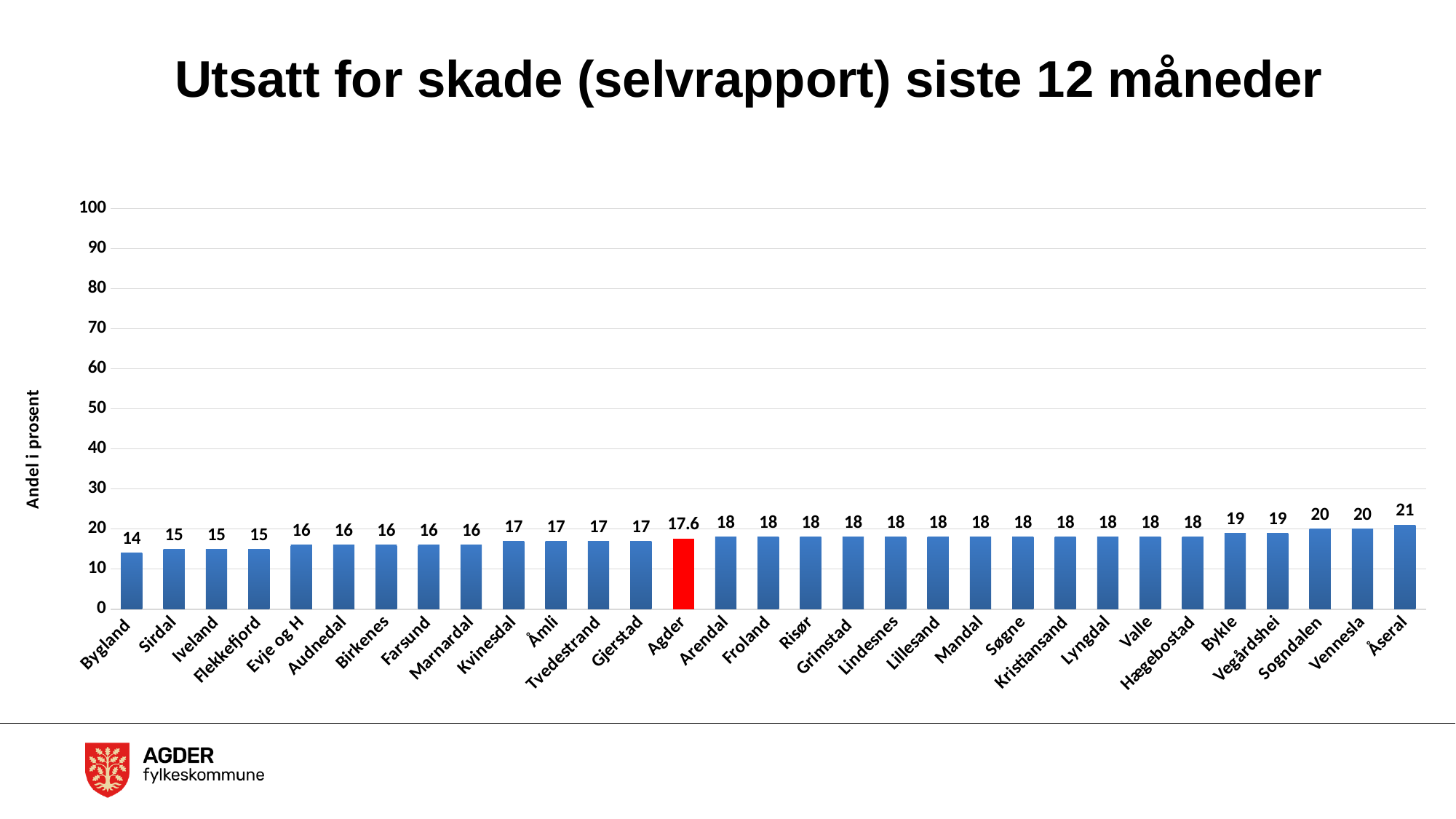
What is the value for Kristiansand? 18 Which category has the lowest value? Bygland Which bar is coloured red? Agder What is the value for Agder? 17.6 Which is larger, the value for Vennesla or the value for Sirdal? Vennesla What is the difference between the values for Åseral and Bygland? 7 How many categories are shown on the x axis? 31 Which category has the highest value? Åseral Do the values rise or fall from left to right along the x axis? rise What kind of chart is this? bar chart What is the value for Bygland? 14